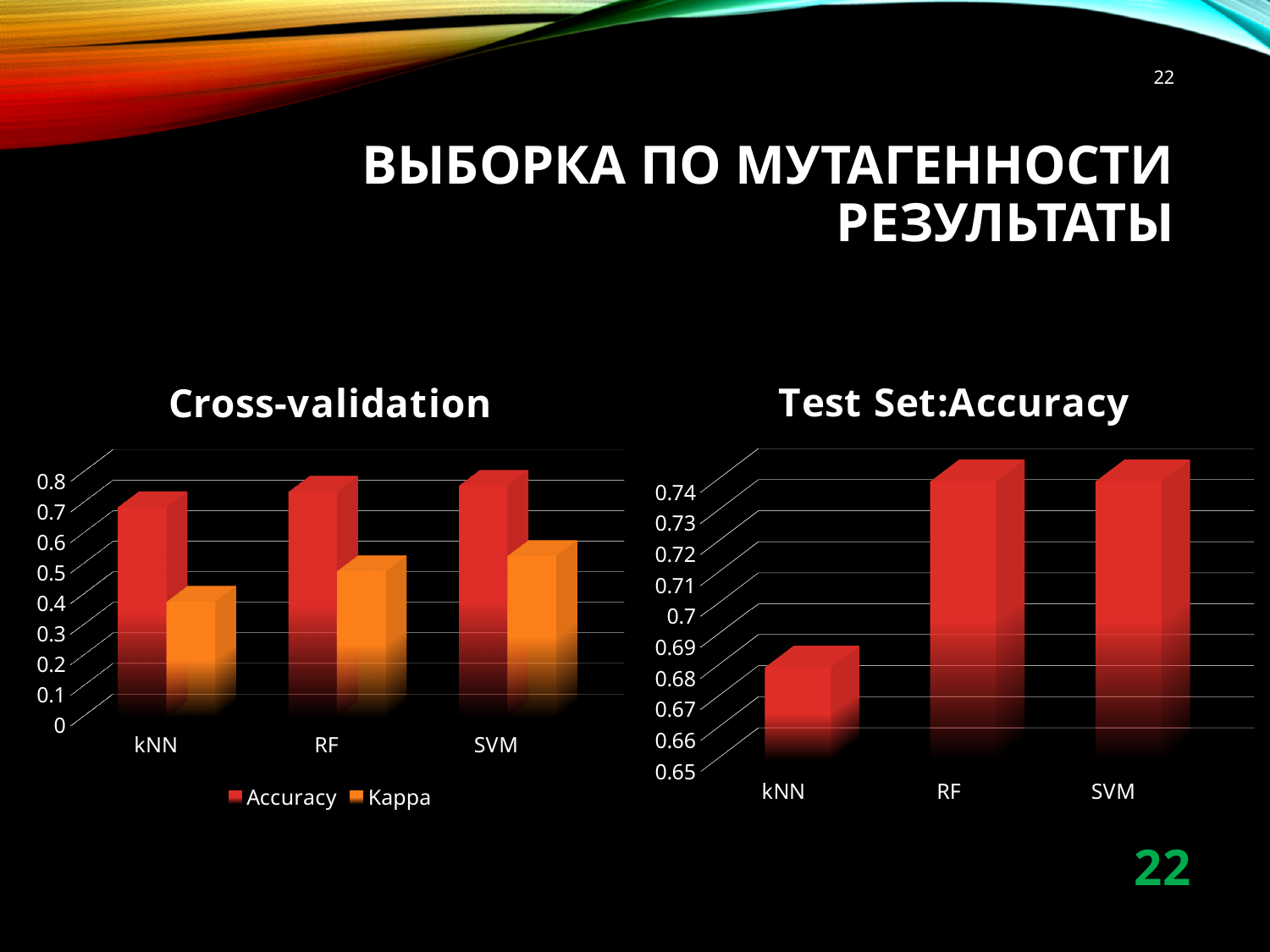
How many categories are shown on the x axis of the Test Set:Accuracy chart? 3 In the Cross-validation chart, is the Kappa value for kNN greater or less than 0.5? less In the Test Set:Accuracy chart, which category has the lowest value? kNN In the Cross-validation chart, is the Accuracy value for SVM greater or less than 0.6? greater In the Test Set:Accuracy chart, which is larger: the value for RF or the value for kNN? RF In the Cross-validation chart, which category has the highest Kappa value? SVM In the Cross-validation chart, for kNN, which is larger: Accuracy or Kappa? Accuracy In the Test Set:Accuracy chart, is the value for kNN greater or less than 0.7? less What are the series names in the legend of the Cross-validation chart? Accuracy and Kappa How many series does the legend of the Cross-validation chart list? 2 What type of chart is the Cross-validation chart? bar chart In the Cross-validation chart, which category has the lowest Kappa value? kNN